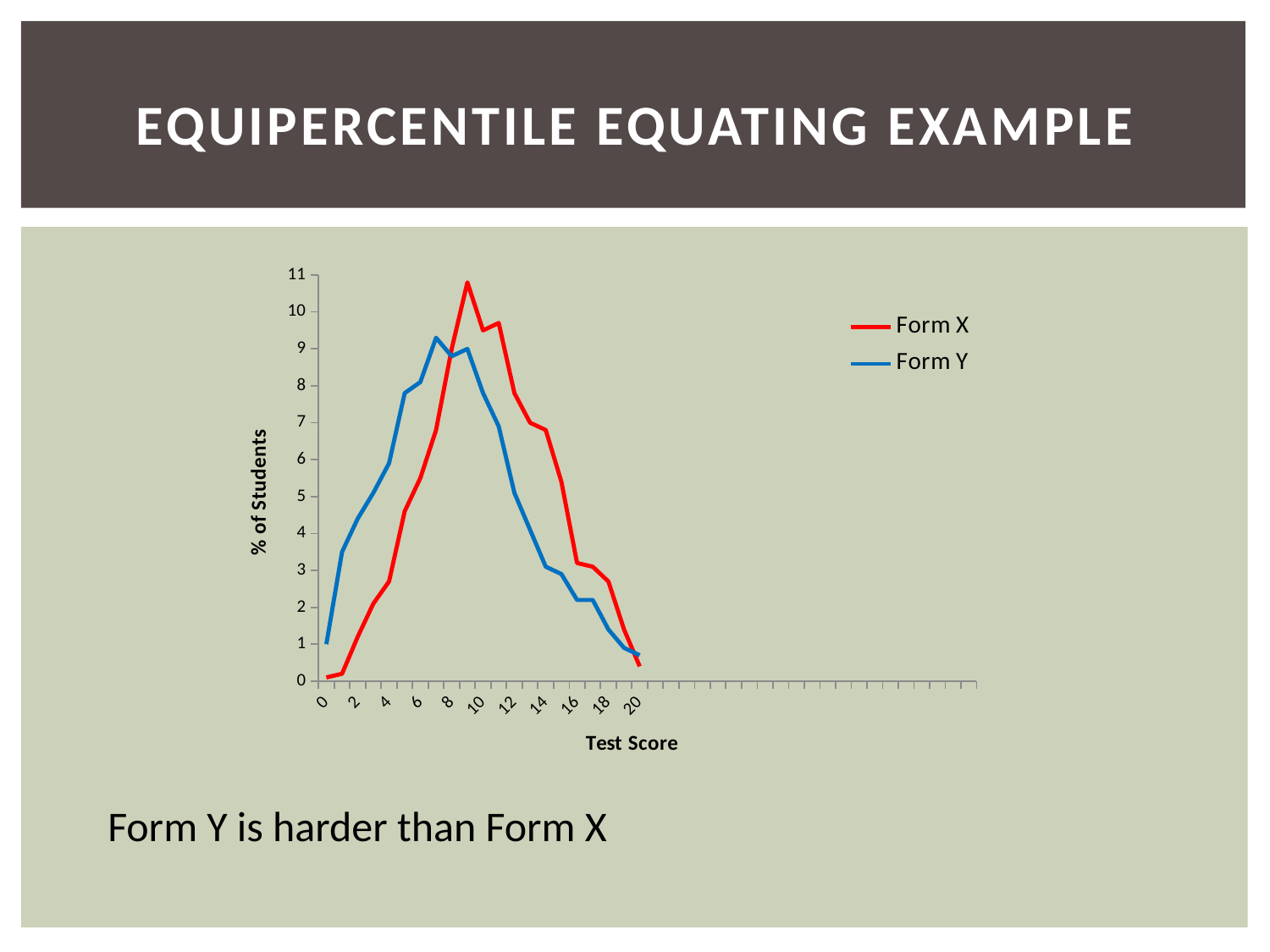
Is the value for Form X at a test score of 20 greater or less than 1? less Is the peak value of Form X greater or less than 10? greater At which test score does the Form Y line reach its highest value? 7 Which series reaches the higher peak, Form X or Form Y? Form X At a test score of 4, which series has the higher value, Form X or Form Y? Form Y At a test score of 14, which series has the higher value, Form X or Form Y? Form X Does the Form X line rise or fall as the test score goes from 12 to 20? fall What colour is the Form X line? red How many series does the legend list? 2 What is the title of the x axis? Test Score At which test score does the Form X line reach its highest value? 9 What kind of chart is shown on the slide? line chart